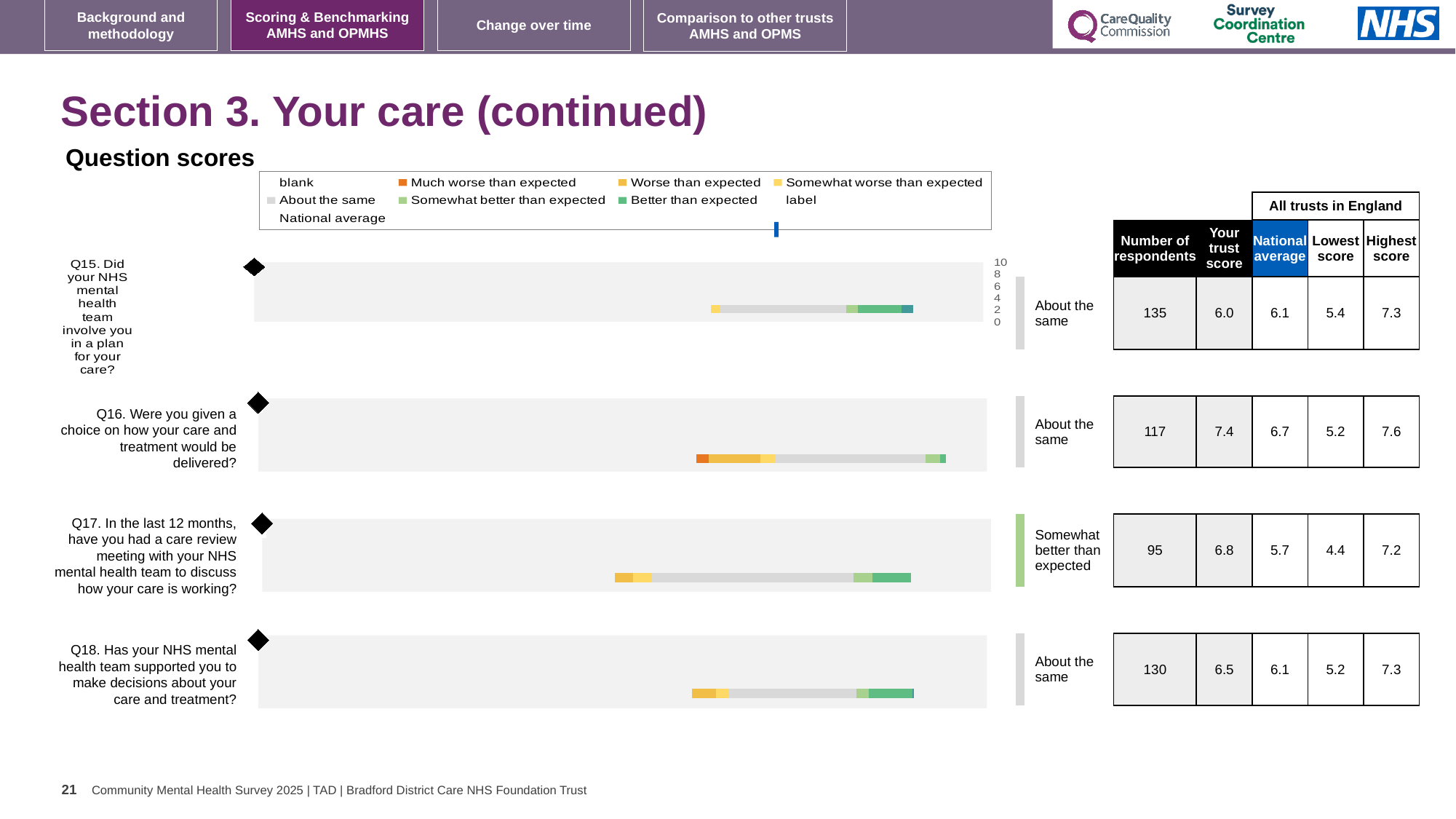
What kind of chart is used to show the question scores? Bar chart Which question has the highest 'Your trust score'? Q16 What is the national average score for Q18 (supported you to make decisions about your care and treatment)? 6.1 What is the 'Your trust score' value for Q16 (Were you given a choice on how your care and treatment would be delivered)? 7.4 What is the difference between the highest score and the lowest score for Q17? 2.8 Which question has the lowest number of respondents? Q17 How many questions are plotted in the question scores chart? 4 What is the highest score across all trusts in England for Q15 (involve you in a plan for your care)? 7.3 How many respondents are recorded for Q17 (care review meeting in the last 12 months)? 95 For Q15, which is larger: the trust score or the national average? National average Which benchmark category label is shown for Q17? Somewhat better than expected By how much does the trust score for Q16 exceed the national average for Q16? 0.7